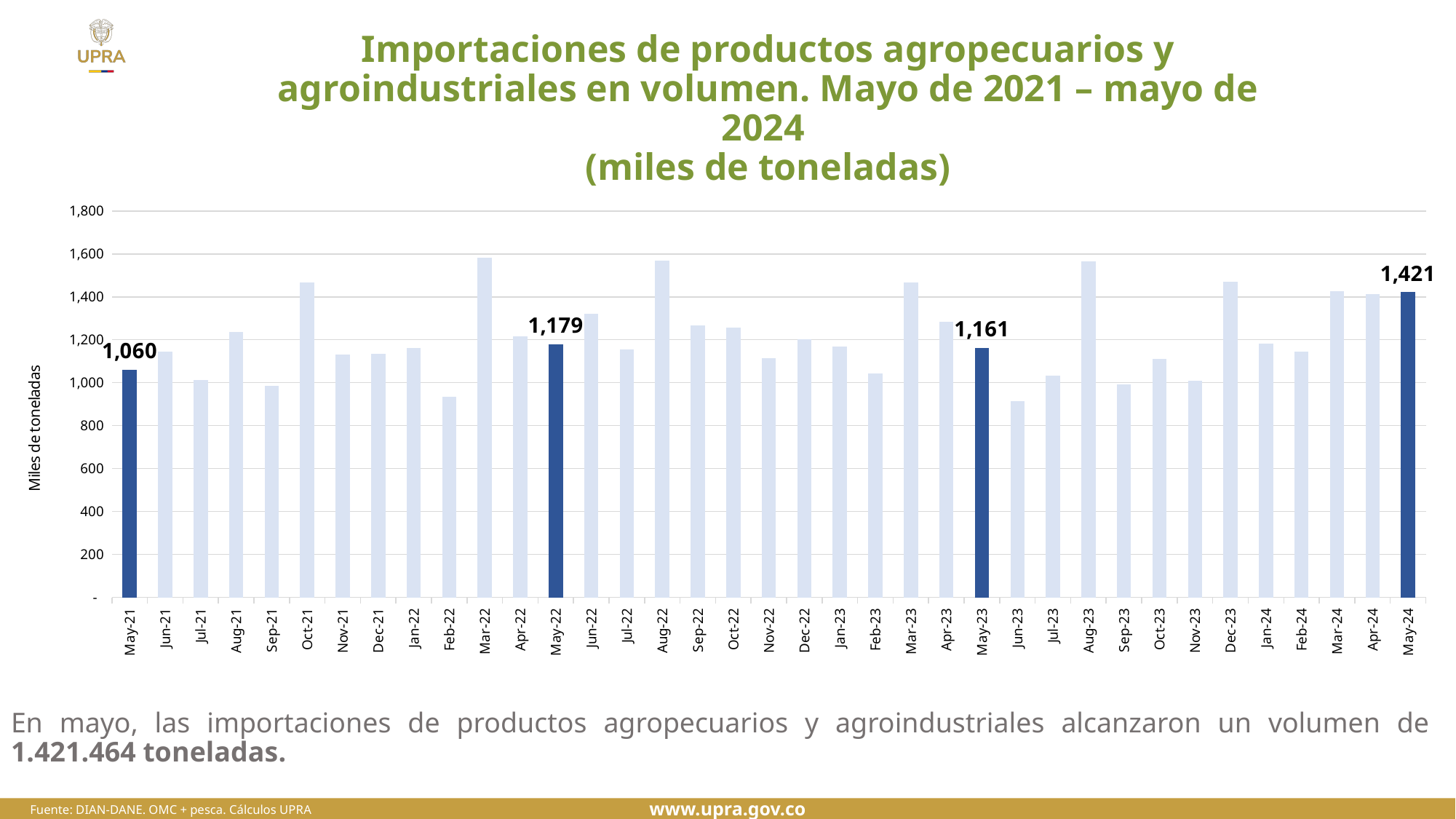
Is the value for Jun-23 greater or less than 1,000? less What is the value for May-23? 1,161 What is the value for May-22? 1,179 Which is larger, the value for May-22 or the value for May-23? May-22 What is the difference between the values for May-24 and May-21? 361 What kind of chart is shown on the slide? Bar chart What is the value for May-24? 1,421 What is the difference between the values for May-22 and May-23? 18 How many monthly bars are plotted in the chart? 37 Is the value for Mar-22 greater or less than 1,400? greater Is the value for Feb-22 greater or less than 1,000? less What is the value for May-21? 1,060